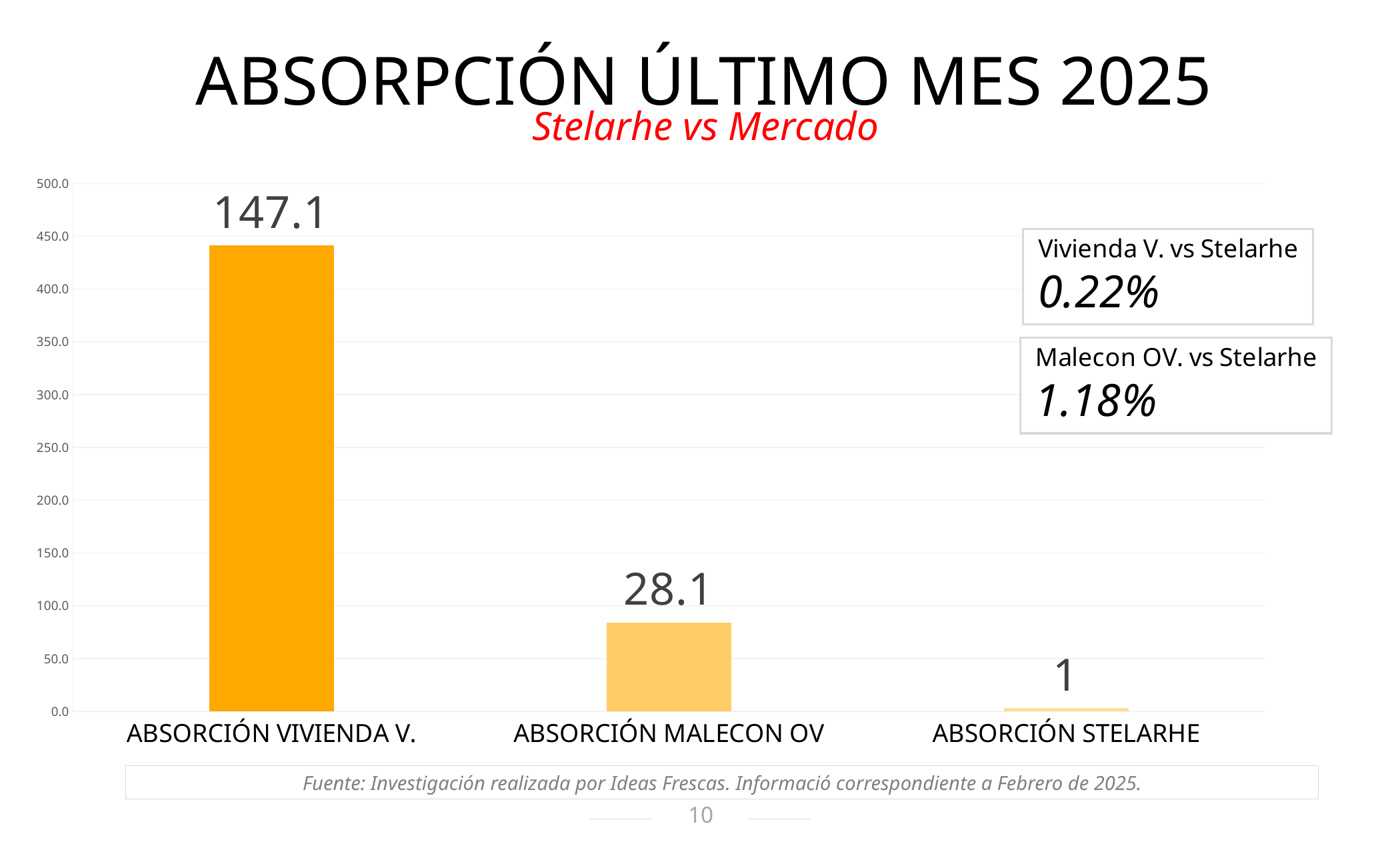
Which is larger, the value for ABSORCIÓN MALECON OV or the value for ABSORCIÓN STELARHE? ABSORCIÓN MALECON OV What is the value for ABSORCIÓN VIVIENDA V.? 147.1 How many categories are shown in the chart? 3 What is the value for ABSORCIÓN MALECON OV? 28.1 What is the value for ABSORCIÓN STELARHE? 1 What is the difference between the values for ABSORCIÓN VIVIENDA V. and ABSORCIÓN MALECON OV? 119.0 What percentage is shown in the box labelled 'Malecon OV. vs Stelarhe'? 1.18% What is the difference between the values for ABSORCIÓN MALECON OV and ABSORCIÓN STELARHE? 27.1 What is the title of the slide? ABSORPCIÓN ÚLTIMO MES 2025 Which category has the highest value? ABSORCIÓN VIVIENDA V. Which category has the lowest value? ABSORCIÓN STELARHE What kind of chart is shown on the slide? Bar chart